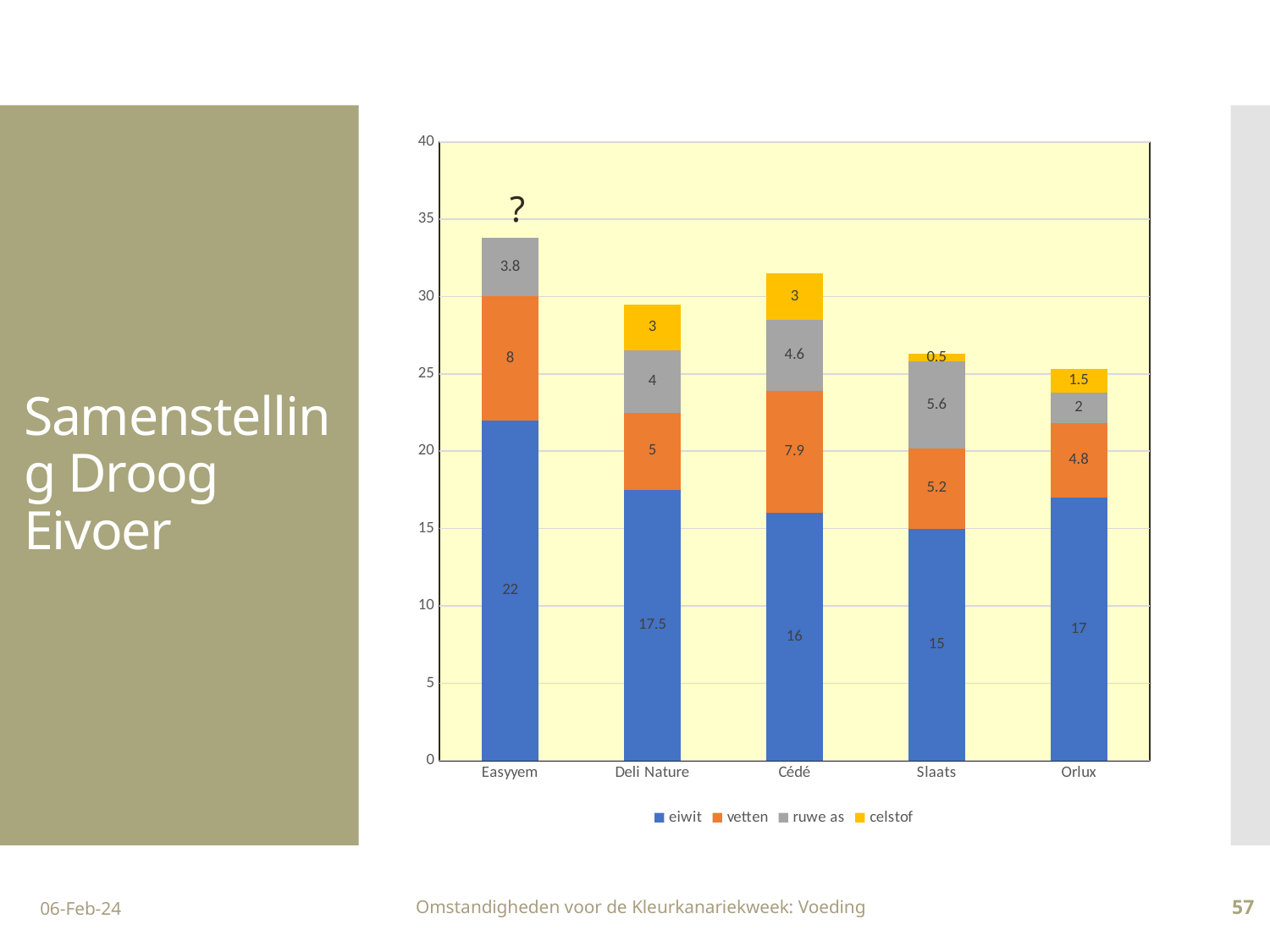
Which category has the lowest eiwit value? Slaats What is the celstof value for Orlux? 1.5 What is the difference between the vetten values for Easyyem and Orlux? 3.2 How many series does the legend list? 4 What is the ruwe as value for Slaats? 5.6 Which has a larger ruwe as value, Cédé or Orlux? Cédé What is the total of the stacked bar for Deli Nature? 29.5 How many categories are shown on the x axis? 5 What is the eiwit value for Deli Nature? 17.5 What is the vetten value for Cédé? 7.9 What kind of chart is shown on the slide? Stacked bar chart Which category has the highest eiwit value? Easyyem